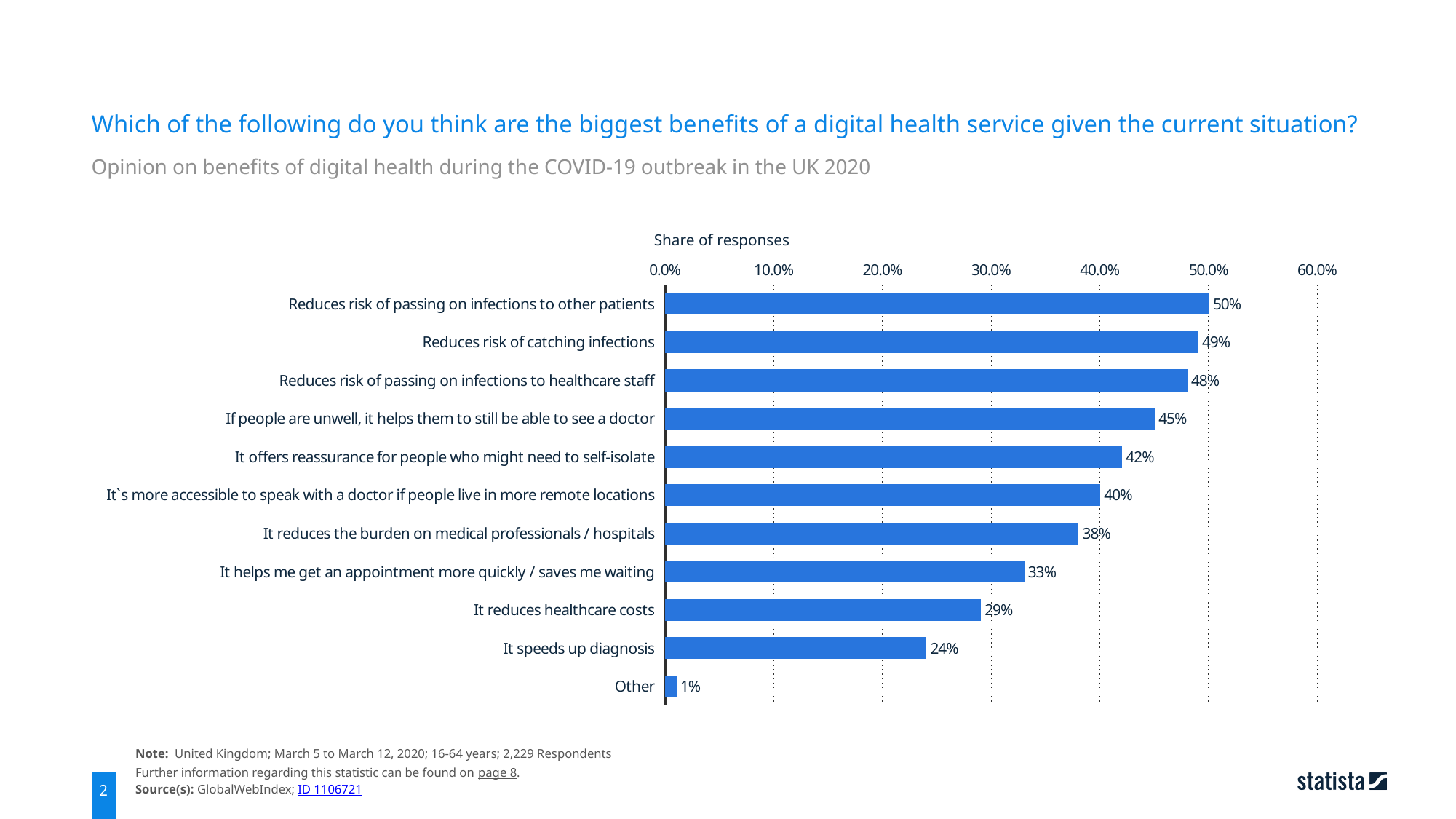
Which category has the lowest share of responses? Other What share of responses is shown for "It reduces healthcare costs"? 29% Which category has the highest share of responses? Reduces risk of passing on infections to other patients Which has a larger share of responses: "It helps me get an appointment more quickly / saves me waiting" or "It reduces healthcare costs"? It helps me get an appointment more quickly / saves me waiting What is the difference between the share for "It offers reassurance for people who might need to self-isolate" and "It reduces the burden on medical professionals / hospitals"? 4% What share of responses is shown for "Reduces risk of catching infections"? 49% Is the value for "If people are unwell, it helps them to still be able to see a doctor" greater or less than 40.0%? greater What kind of chart is shown on the slide? Bar chart What is the highest tick value shown on the horizontal axis? 60.0% What is the label of the horizontal axis? Share of responses How many categories are shown in the chart? 11 What share of responses is shown for "It speeds up diagnosis"? 24%